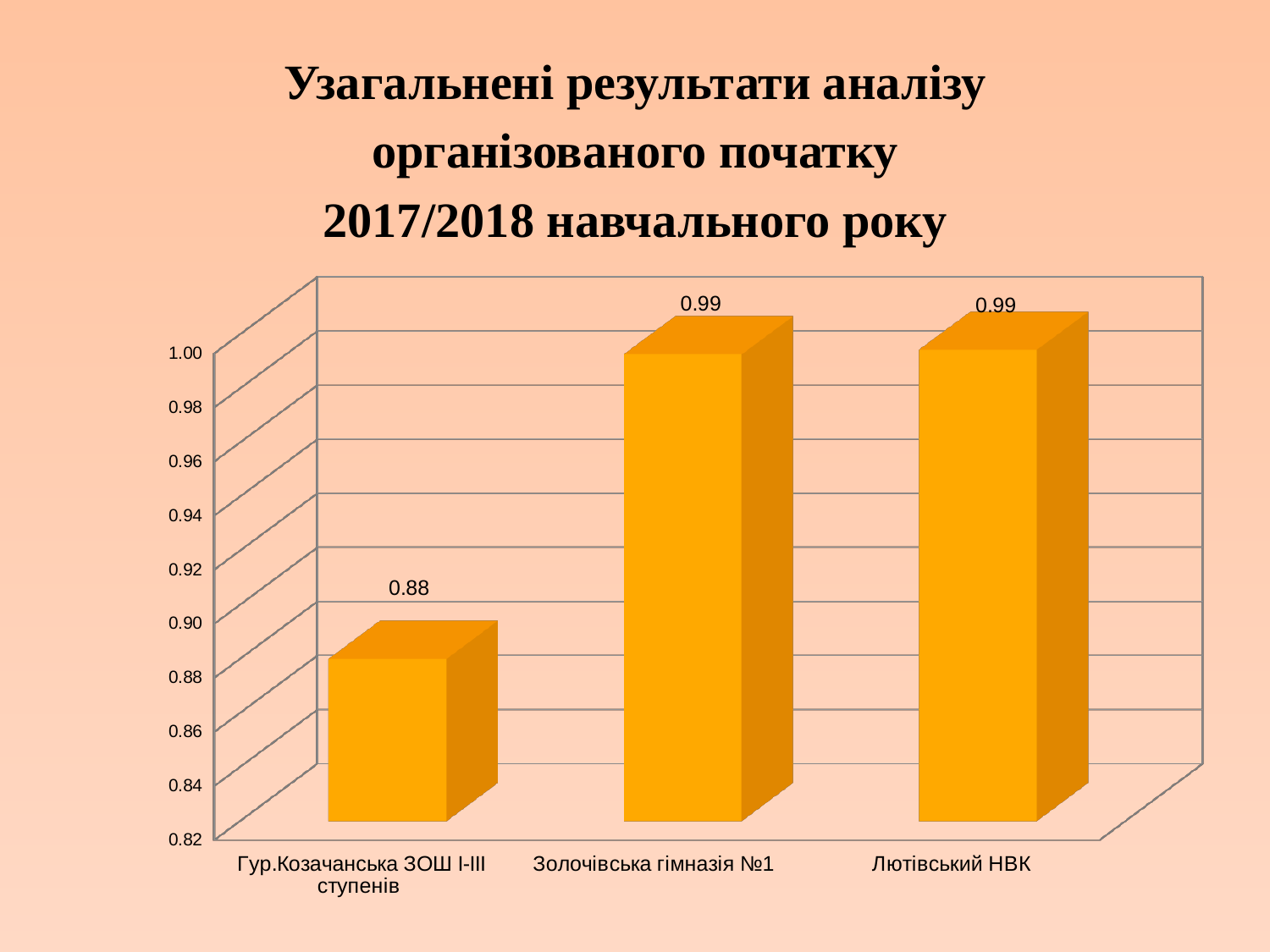
Is the value for Золочівська гімназія №1 greater or less than 0.96? greater How many categories are shown on the chart? 3 Is the value for Гур.Козачанська ЗОШ І-ІІІ ступенів greater or less than 0.90? less Which category has the lowest value? Гур.Козачанська ЗОШ І-ІІІ ступенів What is the value for Лютівський НВК? 0.99 What is the value for Гур.Козачанська ЗОШ І-ІІІ ступенів? 0.88 What kind of chart is shown on the slide? bar chart What is the lowest value shown on the vertical axis? 0.82 What is the value for Золочівська гімназія №1? 0.99 Which is larger, the value for Лютівський НВК or the value for Гур.Козачанська ЗОШ І-ІІІ ступенів? Лютівський НВК What is the difference between the values for Золочівська гімназія №1 and Гур.Козачанська ЗОШ І-ІІІ ступенів? 0.11 What is the title of the slide? Узагальнені результати аналізу організованого початку 2017/2018 навчального року